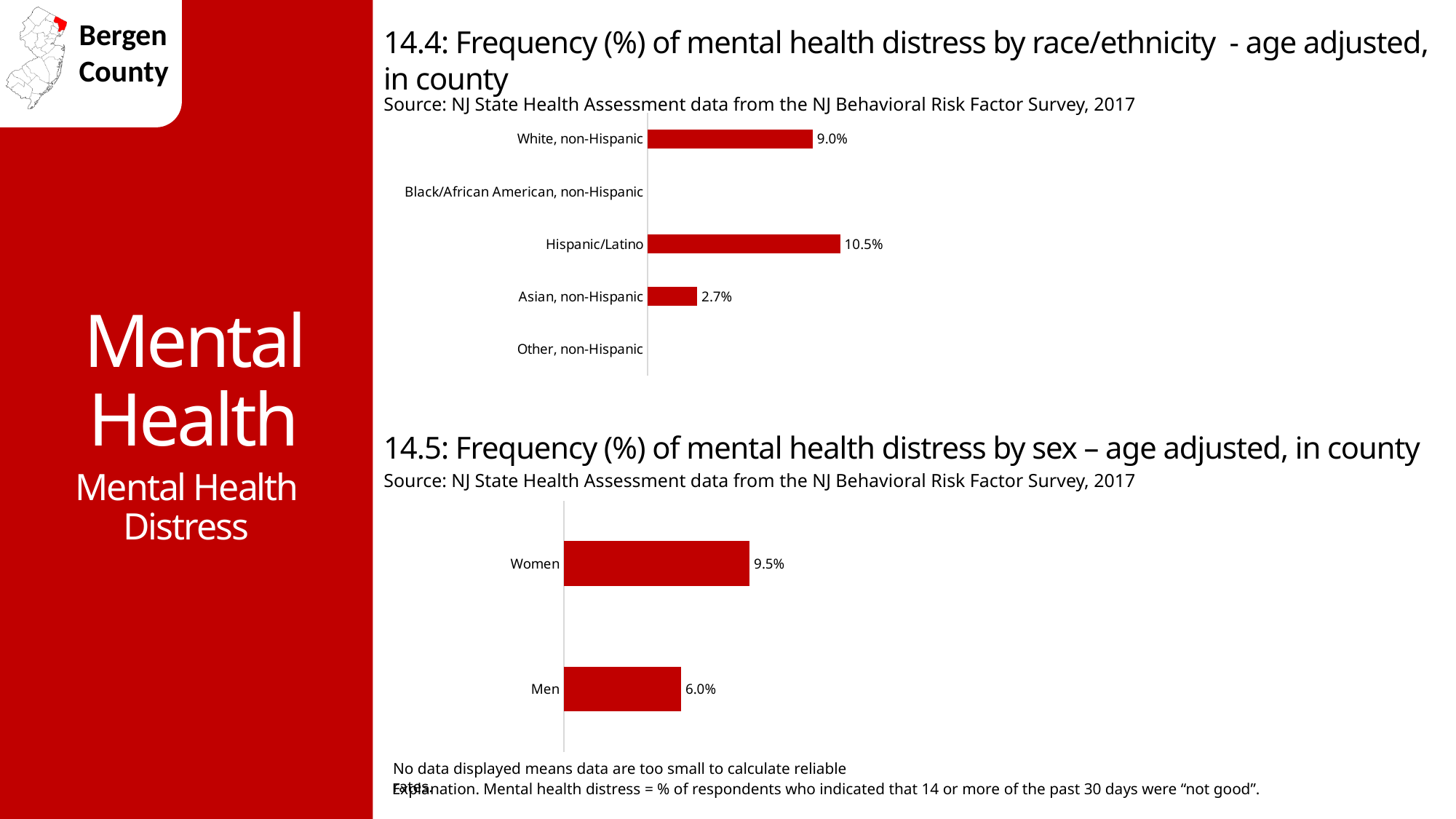
In chart 14.4 (mental health distress by race/ethnicity), what is the value for Hispanic/Latino? 10.5% In chart 14.5 (mental health distress by sex), what is the value for Women? 9.5% In chart 14.4 (mental health distress by race/ethnicity), which categories have no bar displayed? Black/African American, non-Hispanic and Other, non-Hispanic In chart 14.4 (mental health distress by race/ethnicity), what is the value for White, non-Hispanic? 9.0% In chart 14.4 (mental health distress by race/ethnicity), what is the value for Asian, non-Hispanic? 2.7% In chart 14.5 (mental health distress by sex), what is the difference between the Women and Men values? 3.5% In chart 14.4 (mental health distress by race/ethnicity), what is the difference between the Hispanic/Latino and White, non-Hispanic values? 1.5% In chart 14.4 (mental health distress by race/ethnicity), which category with a displayed bar has the lowest value? Asian, non-Hispanic In chart 14.4 (mental health distress by race/ethnicity), which category has the highest value? Hispanic/Latino In chart 14.5 (mental health distress by sex), what is the value for Men? 6.0% What type of chart is chart 14.5 (mental health distress by sex)? Bar chart In chart 14.4 (mental health distress by race/ethnicity), how many category labels are listed on the axis? 5